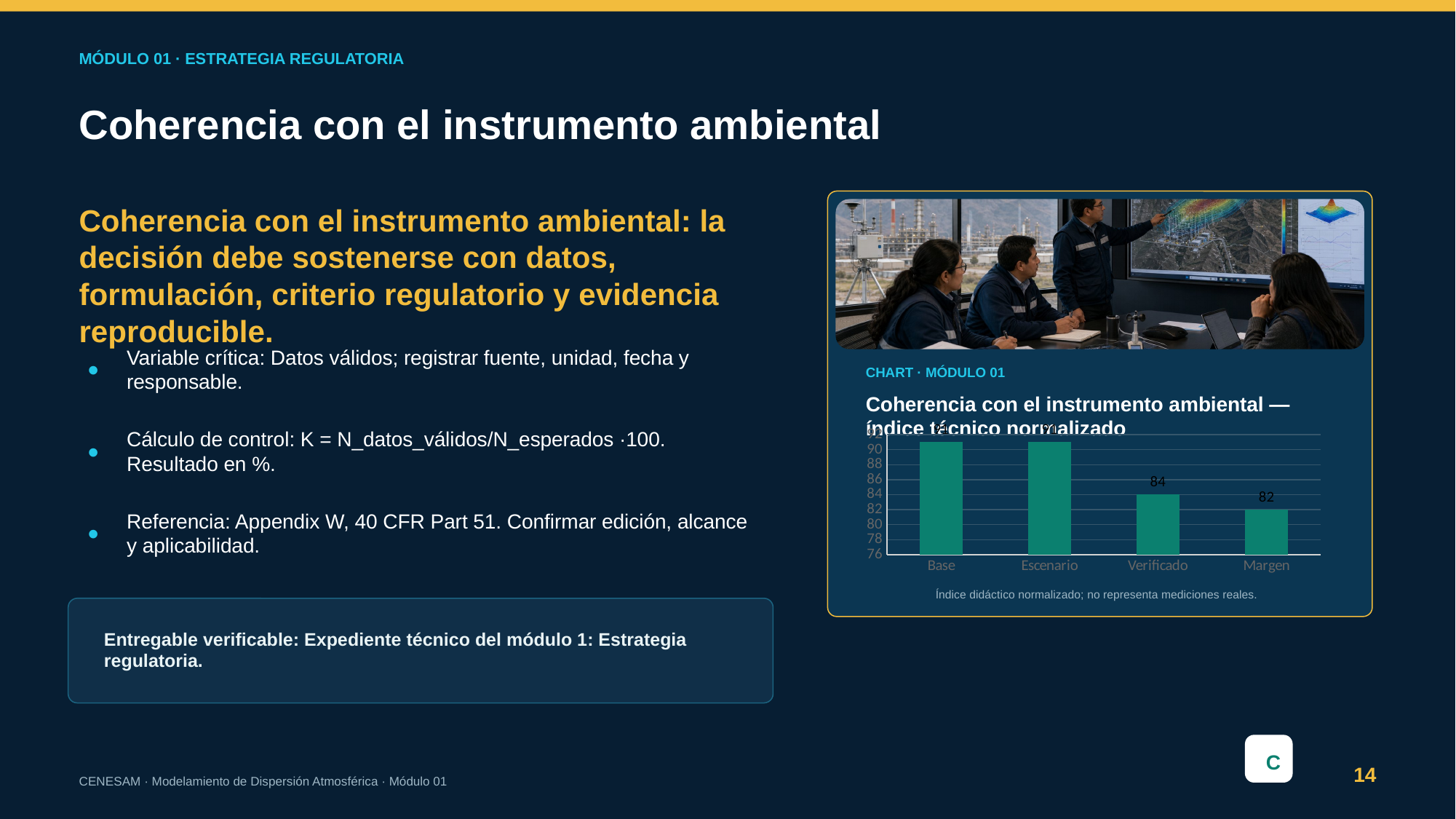
Is the value for Escenario greater or less than 88? greater What type of chart is shown on the slide? bar chart What is the value for Margen? 82 Is the value for Margen greater or less than 84? less What is the difference between the values for Verificado and Margen? 2 Do the values generally rise or fall from Base to Margen along the x axis? fall Is the value for Base greater or less than 86? greater Which is larger, the value for Verificado or the value for Margen? Verificado What is the value for Verificado? 84 Which category has the lowest value? Margen What is the title of the chart? Coherencia con el instrumento ambiental — índice técnico normalizado How many categories are shown on the x axis? 4